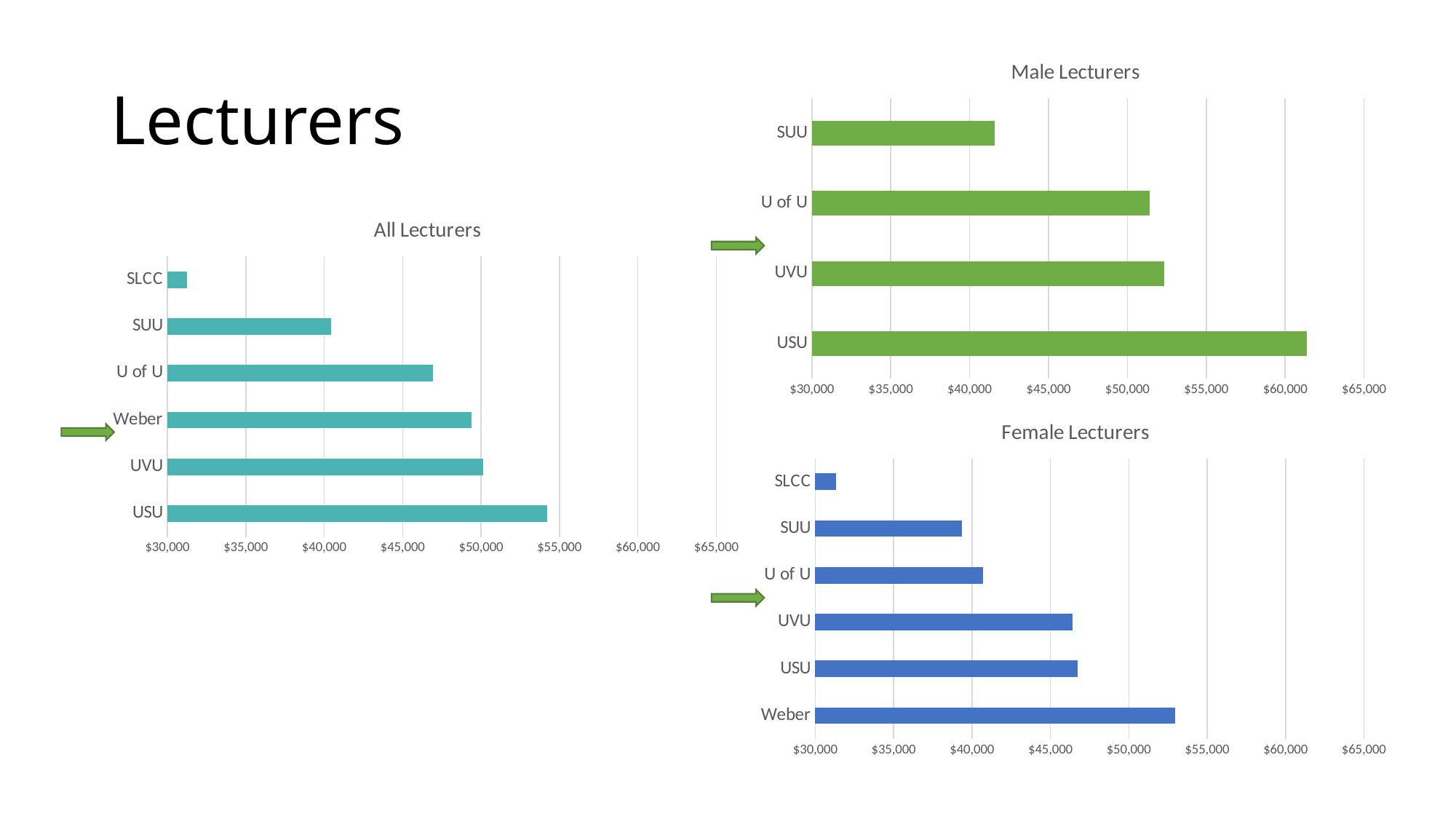
In the All Lecturers chart, which institution has the lowest value? SLCC In the All Lecturers chart, which is larger, the value for USU or the value for U of U? USU In the All Lecturers chart, which institution has the highest value? USU In the All Lecturers chart, how many institutions are shown? 6 In the Female Lecturers chart, which institution has the highest value? Weber In the Male Lecturers chart, is the value for SUU greater or less than $45,000? less In the Female Lecturers chart, is the value for Weber greater or less than $50,000? greater In the Male Lecturers chart, which institution has the lowest value? SUU What kind of chart is the Female Lecturers chart? bar chart In the Male Lecturers chart, how many institutions are shown? 4 In the All Lecturers chart, is the value for USU greater or less than $50,000? greater In the Male Lecturers chart, which institution has the highest value? USU